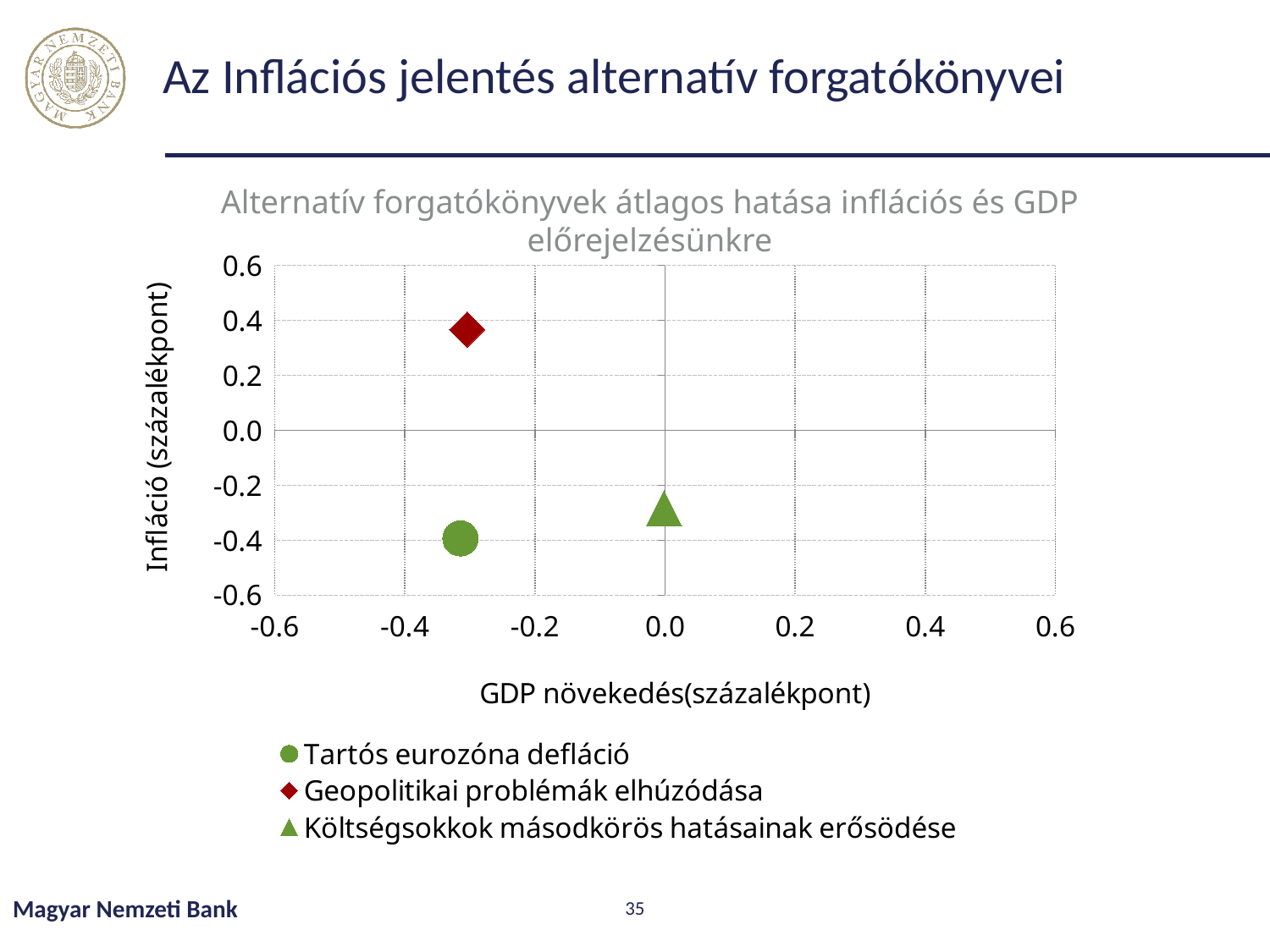
How many series does the legend list? 3 Is the inflation value for Tartós eurozóna defláció greater or less than -0.2? less Is the inflation value for Geopolitikai problémák elhúzódása greater or less than 0.2? greater How many data points are plotted on the chart? 3 Which has the larger inflation effect: Geopolitikai problémák elhúzódása or Tartós eurozóna defláció? Geopolitikai problémák elhúzódása Which scenario has the highest GDP growth effect (x axis)? Költségsokkok másodkörös hatásainak erősödése What kind of chart is shown on the slide? scatter chart Which scenario has the lowest inflation effect (y axis)? Tartós eurozóna defláció Is the GDP growth value for Költségsokkok másodkörös hatásainak erősödése greater or less than -0.2? greater Which scenario has the highest inflation effect (y axis)? Geopolitikai problémák elhúzódása Which has the larger GDP growth effect: Költségsokkok másodkörös hatásainak erősödése or Tartós eurozóna defláció? Költségsokkok másodkörös hatásainak erősödése What is the label of the vertical axis of the chart? Infláció (százalékpont)